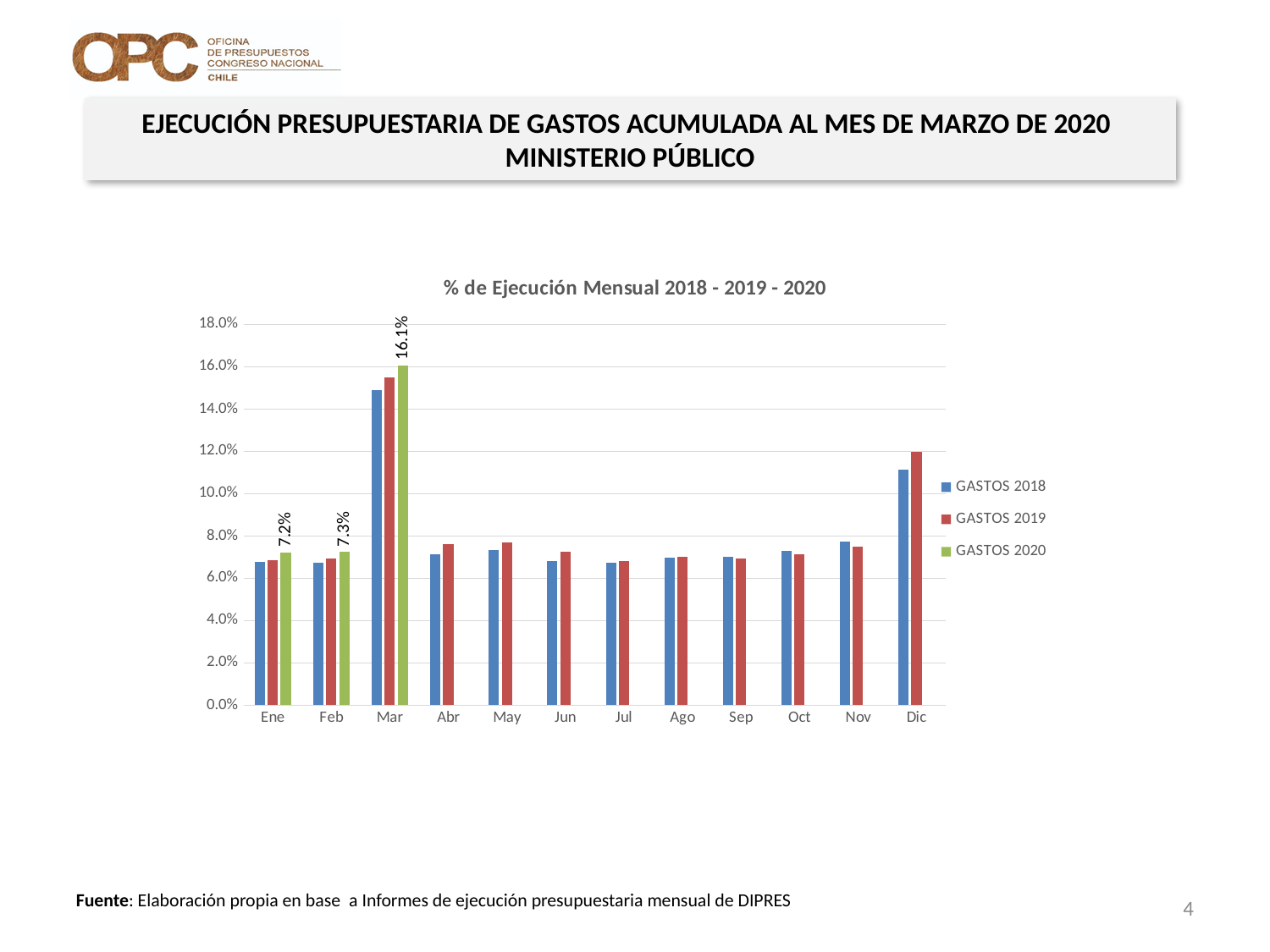
For GASTOS 2018, which month has the larger value, Mar or Dic? Mar What is the difference between the GASTOS 2020 values for Mar and Feb? 8.8 percentage points Is the value for GASTOS 2018 in Mar greater or less than 14.0%? greater Is the value for GASTOS 2019 in Dic greater or less than 10.0%? greater How many series does the legend list? 3 What is the value for GASTOS 2020 in Mar? 16.1% How many months are shown on the x axis? 12 What is the value for GASTOS 2020 in Ene? 7.2% In which month is the GASTOS 2020 value highest? Mar In which month is the GASTOS 2020 value lowest? Ene What is the value for GASTOS 2020 in Feb? 7.3% What kind of chart is shown on the slide? Bar chart